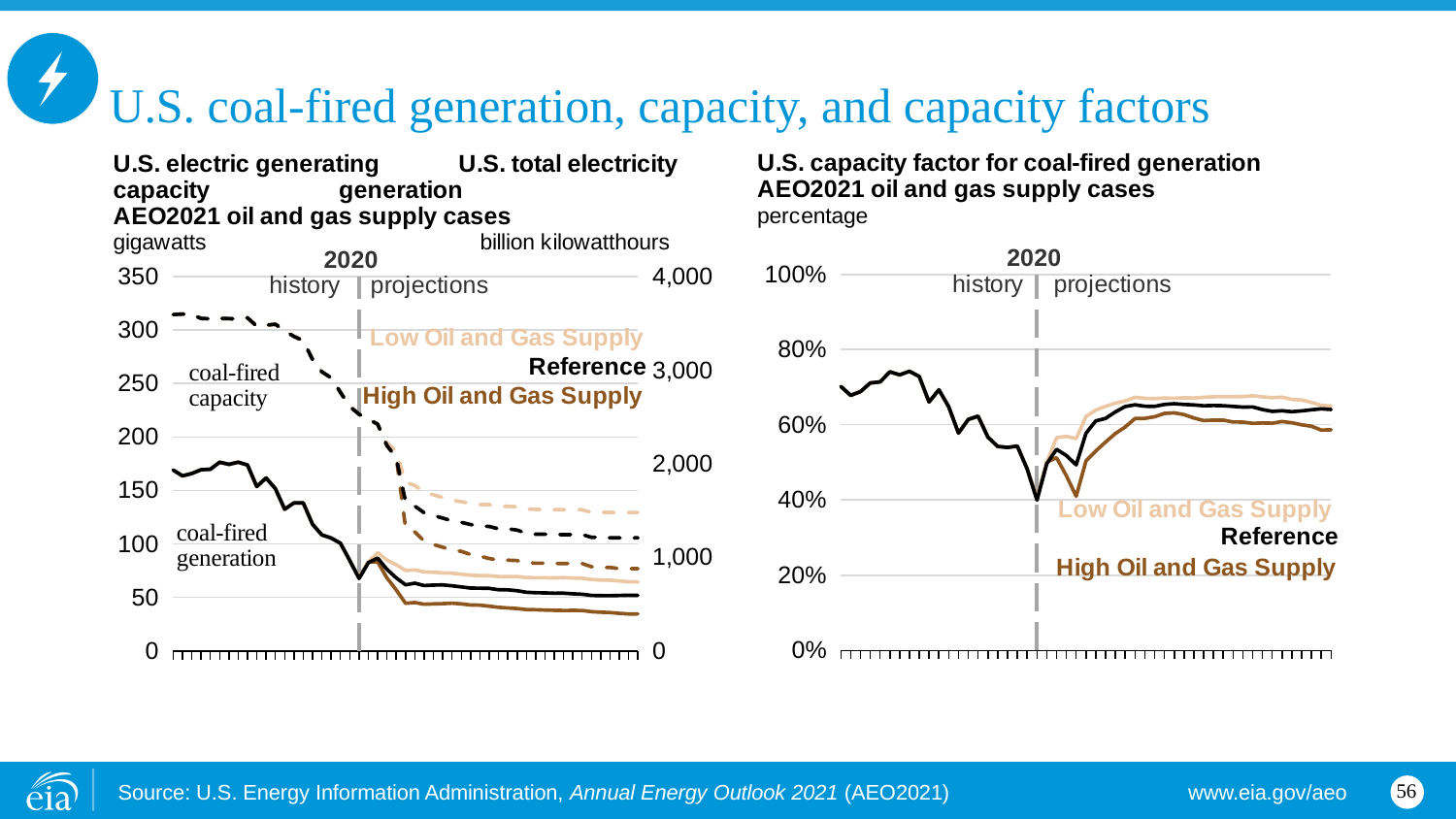
In the right chart, 'U.S. capacity factor for coal-fired generation', is the Low Oil and Gas Supply capacity factor at the end of the projections greater or less than 60%? greater In the left chart, 'U.S. electric generating capacity / U.S. total electricity generation', is coal-fired capacity at the start of the history period greater or less than 300 gigawatts? greater What kind of chart is the 'U.S. capacity factor for coal-fired generation' chart on the right? line chart In the right chart, 'U.S. capacity factor for coal-fired generation', which case has the lowest capacity factor at the end of the projection period? High Oil and Gas Supply In the right chart, 'U.S. capacity factor for coal-fired generation', how many oil and gas supply cases are labelled? 3 In the left chart, 'U.S. electric generating capacity / U.S. total electricity generation', does coal-fired capacity rise or fall over the history period? fall In the left chart, 'U.S. electric generating capacity / U.S. total electricity generation', is the High Oil and Gas Supply coal-fired capacity at the end of the projections greater or less than 100 gigawatts? less In the left chart, what unit is shown on the right-hand axis for coal-fired generation? billion kilowatthours In the left chart, 'U.S. electric generating capacity / U.S. total electricity generation', which case has the highest coal-fired capacity at the end of the projection period? Low Oil and Gas Supply In the right chart, 'U.S. capacity factor for coal-fired generation', which case has the highest capacity factor at the end of the projection period? Low Oil and Gas Supply In the right chart, 'U.S. capacity factor for coal-fired generation', does the capacity factor rise or fall over the history period up to 2020? fall